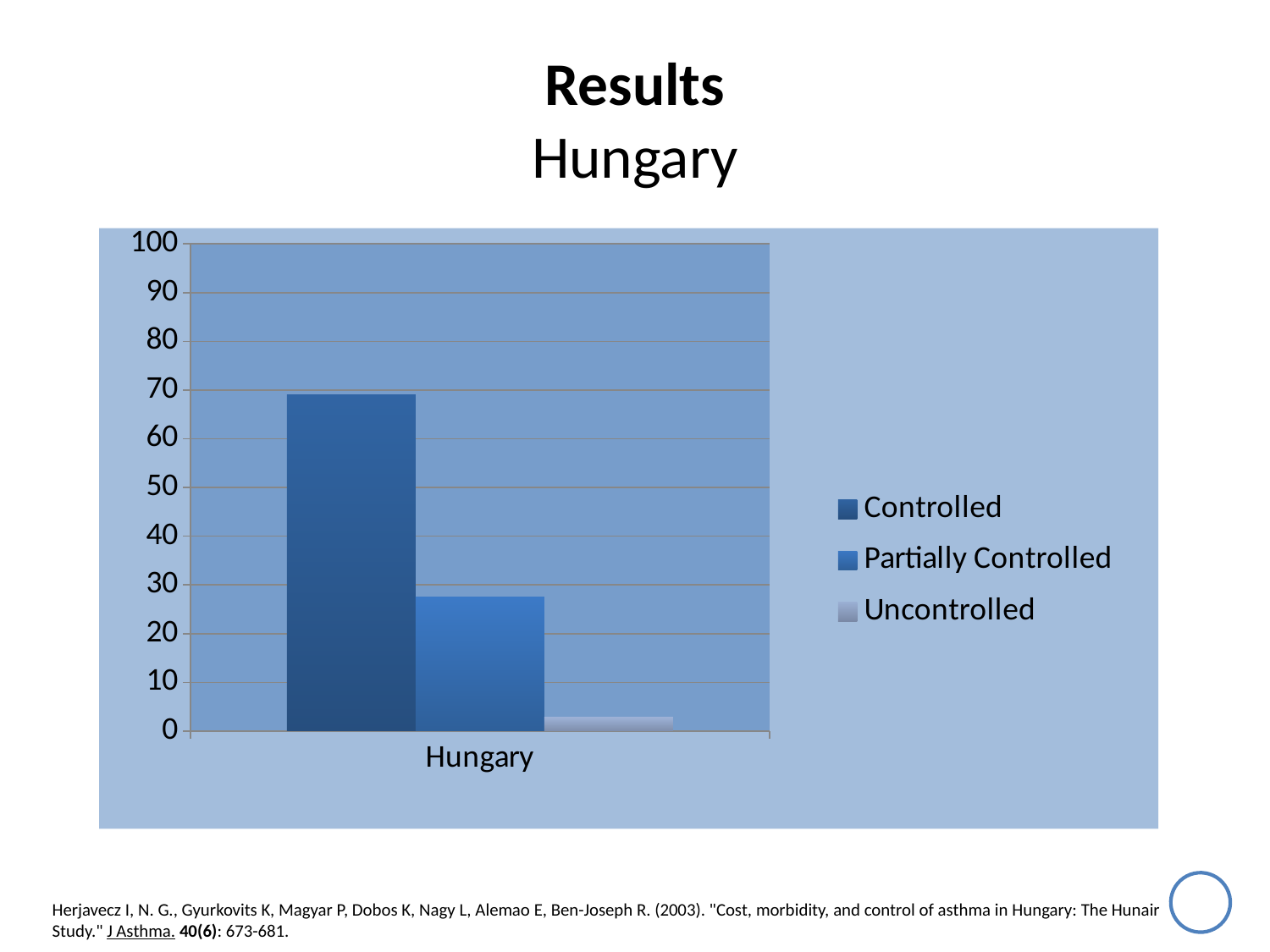
Is the value for Partially Controlled greater or less than 20? greater What kind of chart is shown on the slide? bar chart Is the value for Controlled greater or less than 80? less Is the value for Uncontrolled greater or less than 10? less How many series does the legend list? 3 Which series has the highest value for Hungary? Controlled How many categories are shown on the x axis? 1 Which series has the lowest value for Hungary? Uncontrolled What is the category label shown on the x axis? Hungary Which is larger, the value for Partially Controlled or the value for Uncontrolled? Partially Controlled